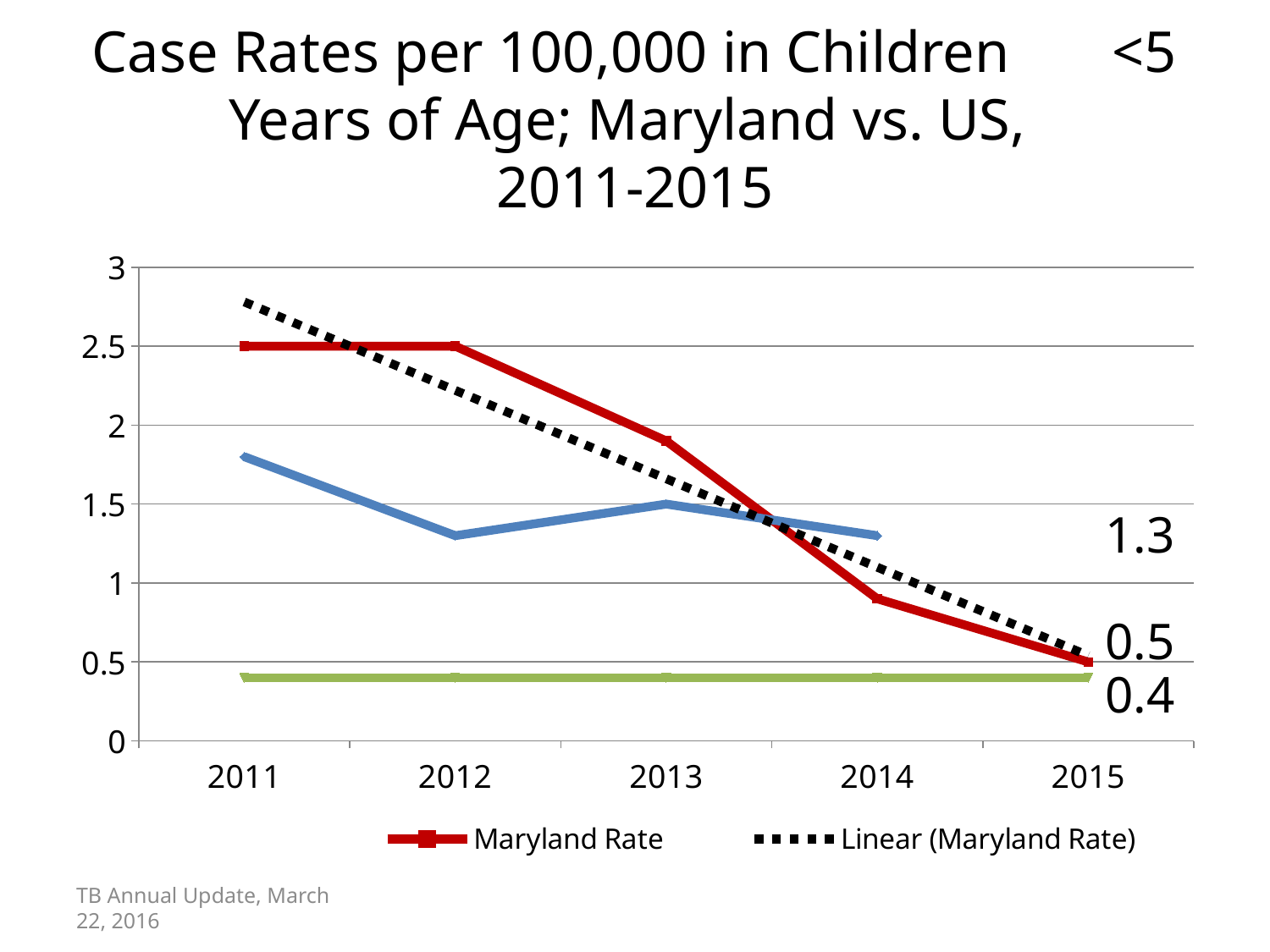
Which is larger, the Maryland Rate in 2012 or in 2014? 2012 Is the Maryland Rate in 2013 greater or less than 1.5? greater What kind of chart is shown on the slide? line chart In which year is the Maryland Rate lowest? 2015 Is the Maryland Rate in 2011 greater or less than 2? greater How many series does the legend list? 2 How many years are shown on the x axis? 5 What is the title of the chart? Case Rates per 100,000 in Children <5 Years of Age; Maryland vs. US, 2011-2015 What colour is the Maryland Rate line? red Does the Maryland Rate rise or fall from 2011 to 2015? fall Is the Maryland Rate in 2014 greater or less than 1.5? less What is the Maryland Rate in 2015? 0.5